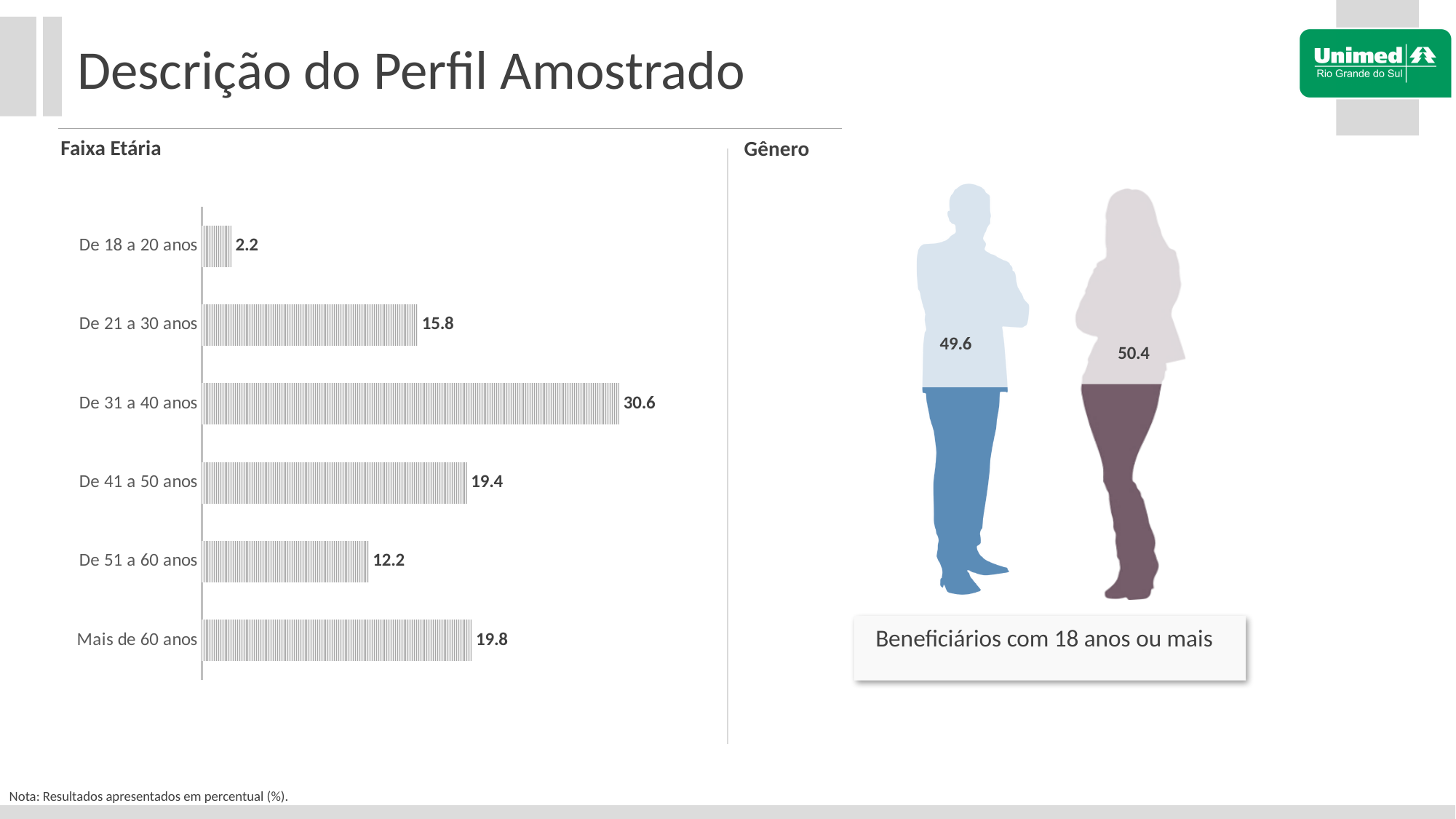
What kind of chart is used for the Faixa Etária data? Bar chart In the Faixa Etária bar chart, which is larger: the value for 'De 21 a 30 anos' or 'De 51 a 60 anos'? De 21 a 30 anos In the Faixa Etária bar chart, what is the difference between the values for 'De 41 a 50 anos' and 'De 51 a 60 anos'? 7.2 How many age groups are shown in the Faixa Etária bar chart? 6 In the Gênero section on the right, what value is shown on the female figure? 50.4 In the Faixa Etária bar chart, which age group has the lowest value? De 18 a 20 anos In the Faixa Etária bar chart, what is the difference between the values for 'De 31 a 40 anos' and 'De 21 a 30 anos'? 14.8 In the Faixa Etária bar chart, what is the value for 'De 31 a 40 anos'? 30.6 In the Faixa Etária bar chart, what is the value for 'De 51 a 60 anos'? 12.2 In the Gênero section on the right, what value is shown on the male figure? 49.6 In the Faixa Etária bar chart, what is the value for 'Mais de 60 anos'? 19.8 In the Faixa Etária bar chart, which age group has the highest value? De 31 a 40 anos